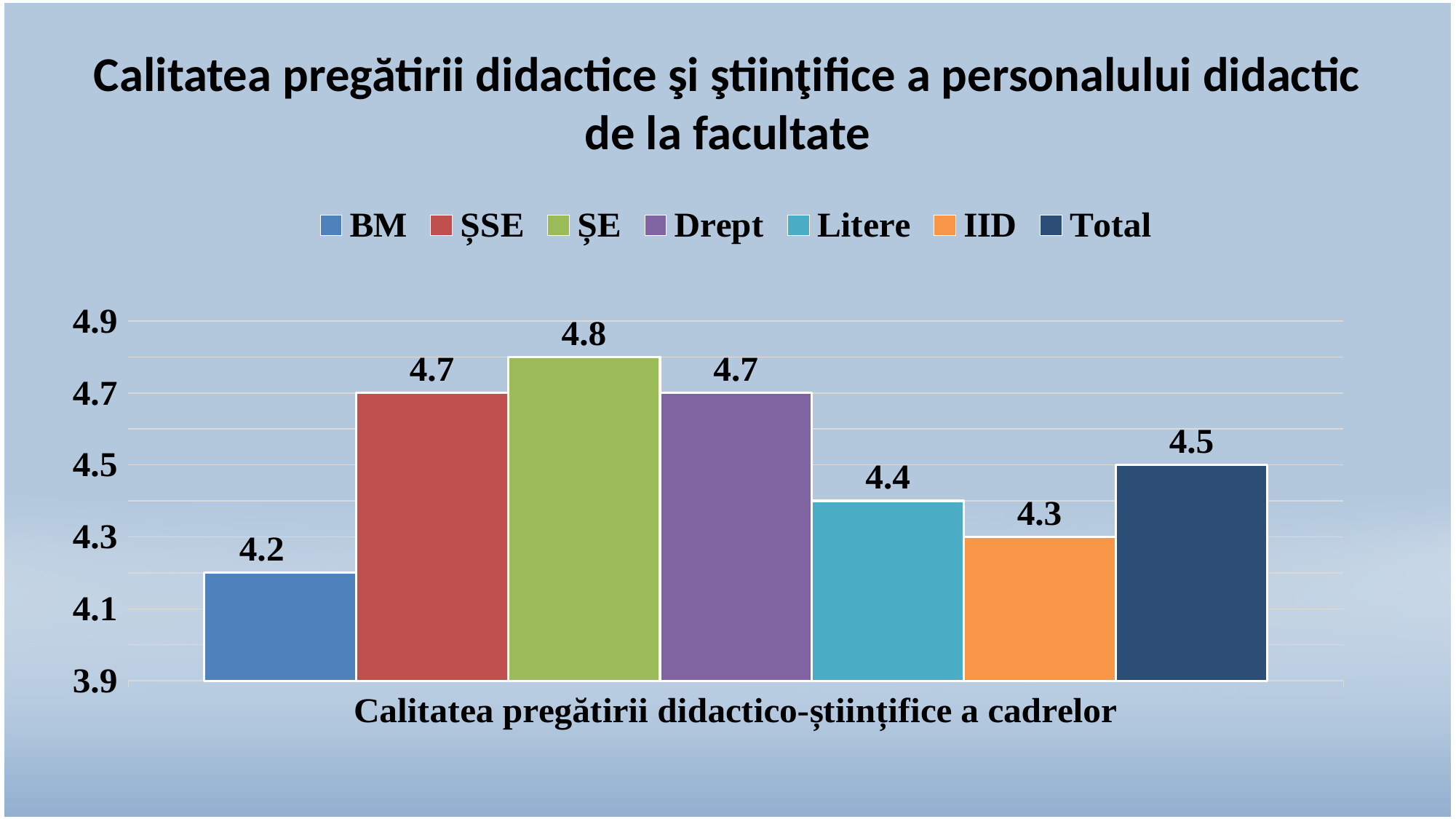
What is the value for Total? 4.5 What is the difference between the values for ȘE and BM? 0.6 What is the value for ȘE? 4.8 How many series does the legend list? 7 What kind of chart is shown on the slide? Bar chart Which series has the highest value? ȘE What is the value for BM? 4.2 What is the value for Litere? 4.4 What is the label on the x axis of the chart? Calitatea pregătirii didactico-științifice a cadrelor Which is larger, the value for Litere or the value for IID? Litere Which series has the lowest value? BM What is the difference between the values for Total and IID? 0.2